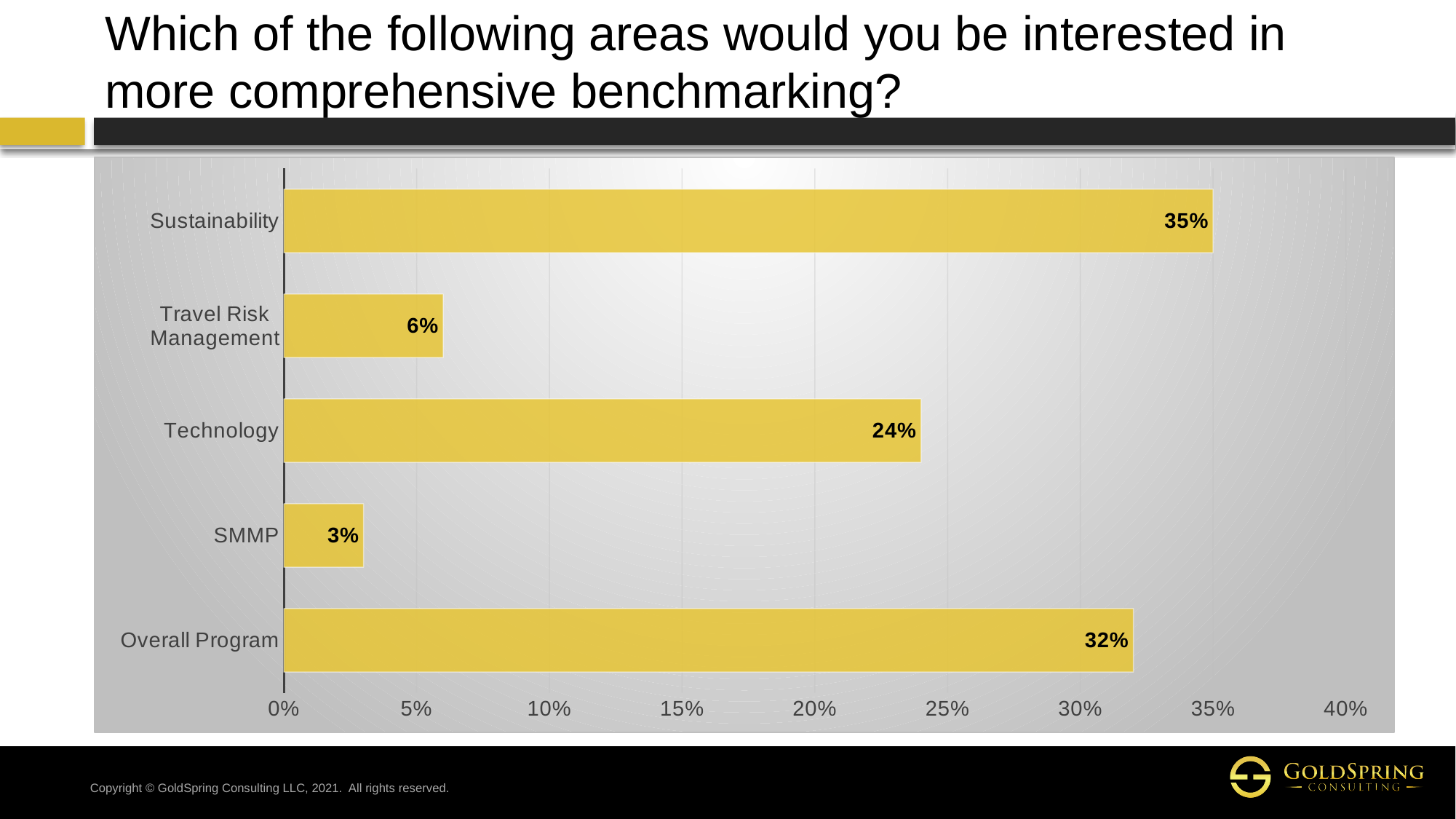
Which is larger, the value for Technology or the value for Travel Risk Management? Technology What is the value for Technology? 24% What is the value for Travel Risk Management? 6% What is the maximum value shown on the horizontal axis? 40% How many categories are shown in the chart? 5 What is the value for Sustainability? 35% Which category has the highest value? Sustainability What is the value for SMMP? 3% What kind of chart is shown on the slide? Bar chart Which category has the lowest value? SMMP What is the difference between the values for Sustainability and Overall Program? 3% What is the value for Overall Program? 32%